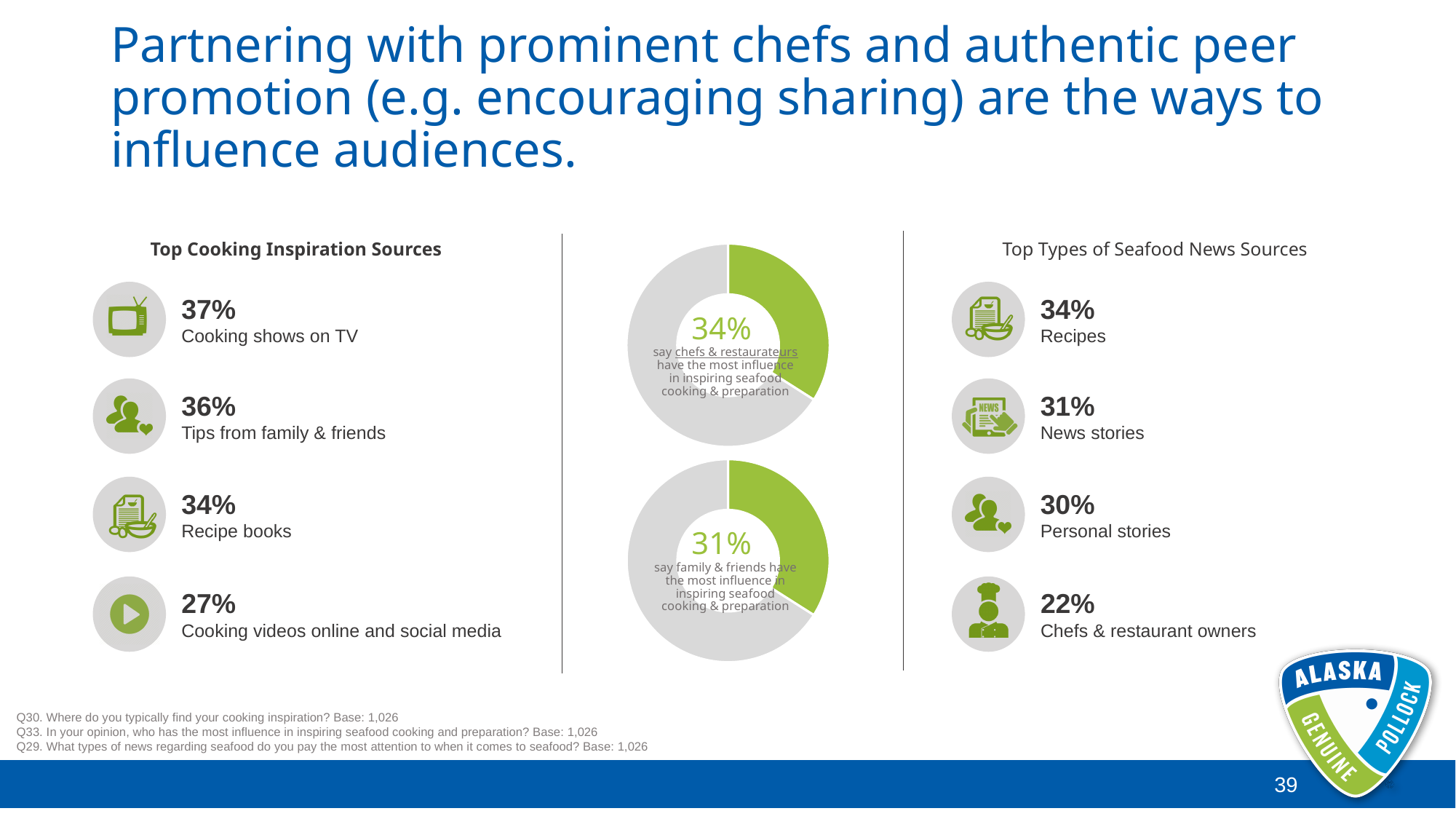
In the Top Cooking Inspiration Sources panel, which source has the highest percentage? Cooking shows on TV What is the difference in percentage points between the chefs & restaurateurs donut (34%) and the family & friends donut (31%)? 3 percentage points In the Top Cooking Inspiration Sources panel, what is the difference between Cooking shows on TV (37%) and Cooking videos online and social media (27%)? 10 percentage points Which of the two donut charts shows the larger share: chefs & restaurateurs or family & friends? Chefs & restaurateurs In the bottom donut chart, what percentage say family & friends have the most influence in inspiring seafood cooking & preparation? 31% In the Top Types of Seafood News Sources panel, which source has the lowest percentage? Chefs & restaurant owners In the Top Types of Seafood News Sources panel, what percentage is shown for News stories? 31% How many donut charts are shown on the slide? 2 What kind of chart is used in the middle of the slide to show the share who say chefs & restaurateurs have the most influence? Donut chart In the top donut chart, what percentage say chefs & restaurateurs have the most influence in inspiring seafood cooking & preparation? 34% What colour is the highlighted segment in the donut charts? Green In the Top Cooking Inspiration Sources panel, what percentage is shown for Recipe books? 34%